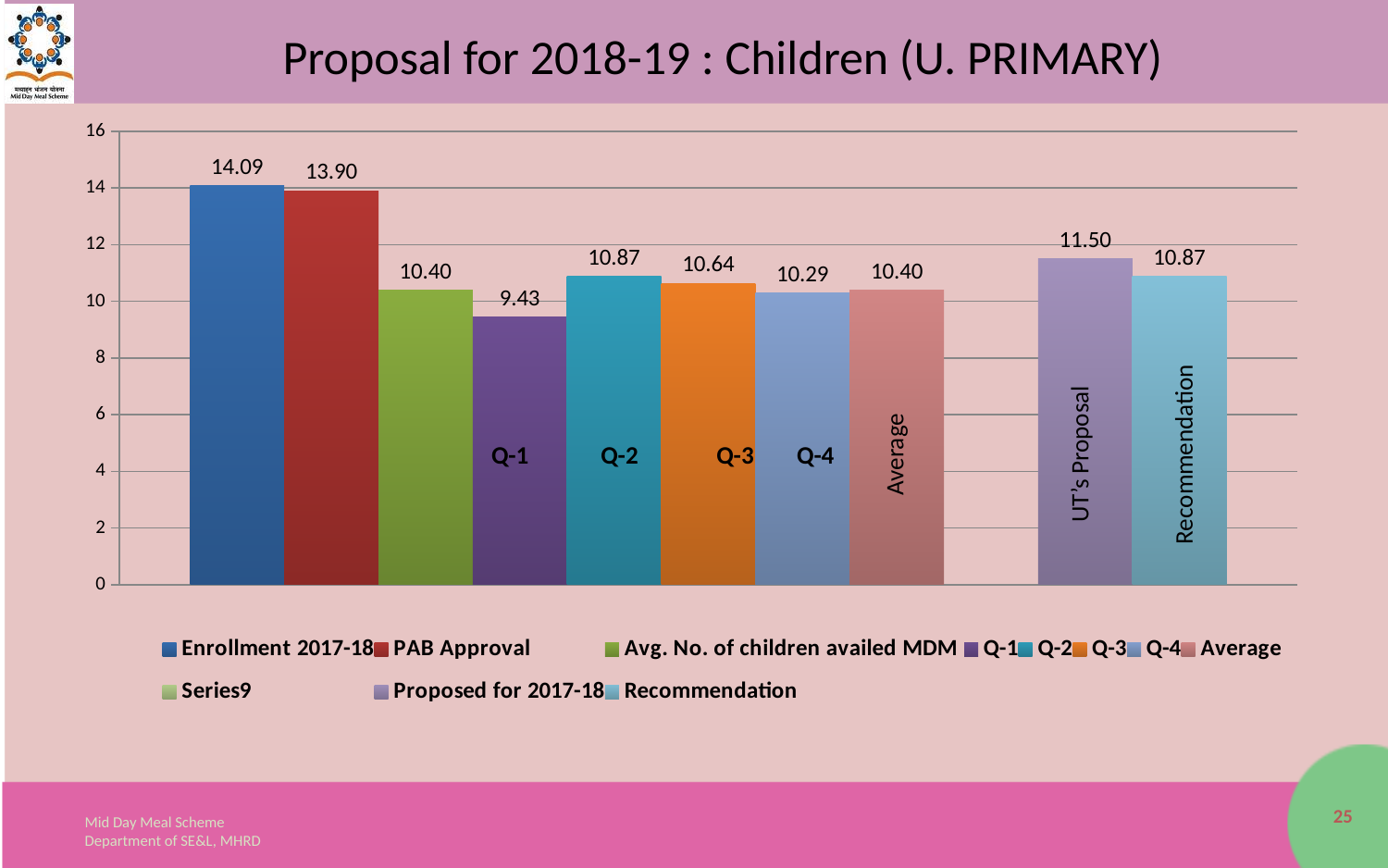
What is the title of the chart on the slide? Proposal for 2018-19 : Children (U. PRIMARY) Which is larger, the Q-2 value or the Q-3 value? Q-2 Which quarter (Q-1 to Q-4) has the lowest value? Q-1 Which bar has the highest value in the chart? Enrollment 2017-18 What is the value of the PAB Approval bar? 13.90 What value is shown for the UT's Proposal bar? 11.50 What is the difference between the UT's Proposal value and the Recommendation value? 0.63 What type of chart is shown on the slide? Bar chart What is the value of the Enrollment 2017-18 bar? 14.09 What value is shown for Q-1? 9.43 What is the difference between the Enrollment 2017-18 value and the PAB Approval value? 0.19 What value is shown for the Recommendation bar? 10.87